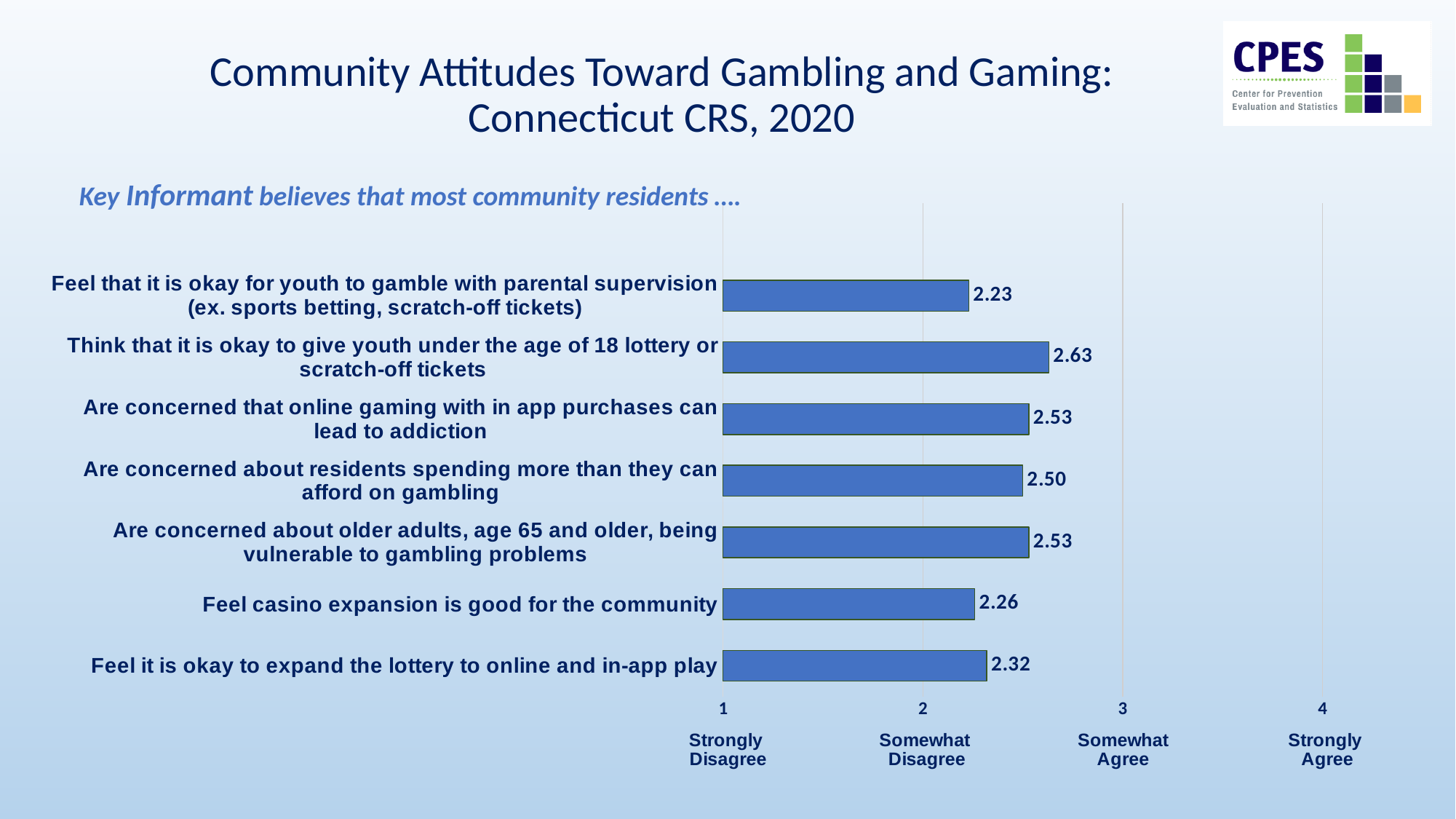
What is the value for "Feel casino expansion is good for the community"? 2.26 How many categories are shown in the chart? 7 What kind of chart is shown on the slide? Bar chart Which is larger: the value for "Feel casino expansion is good for the community" or the value for "Feel it is okay to expand the lottery to online and in-app play"? Feel it is okay to expand the lottery to online and in-app play What is the value for "Feel it is okay to expand the lottery to online and in-app play"? 2.32 Is the value for "Are concerned that online gaming with in app purchases can lead to addiction" greater or less than 3? less Which category has the lowest value? Feel that it is okay for youth to gamble with parental supervision (ex. sports betting, scratch-off tickets) What is the value for "Think that it is okay to give youth under the age of 18 lottery or scratch-off tickets"? 2.63 What is the value for "Are concerned about residents spending more than they can afford on gambling"? 2.50 Which category has the highest value? Think that it is okay to give youth under the age of 18 lottery or scratch-off tickets What is the difference between the values for "Think that it is okay to give youth under the age of 18 lottery or scratch-off tickets" and "Feel that it is okay for youth to gamble with parental supervision"? 0.40 What label does the x axis show at the value 4? Strongly Agree